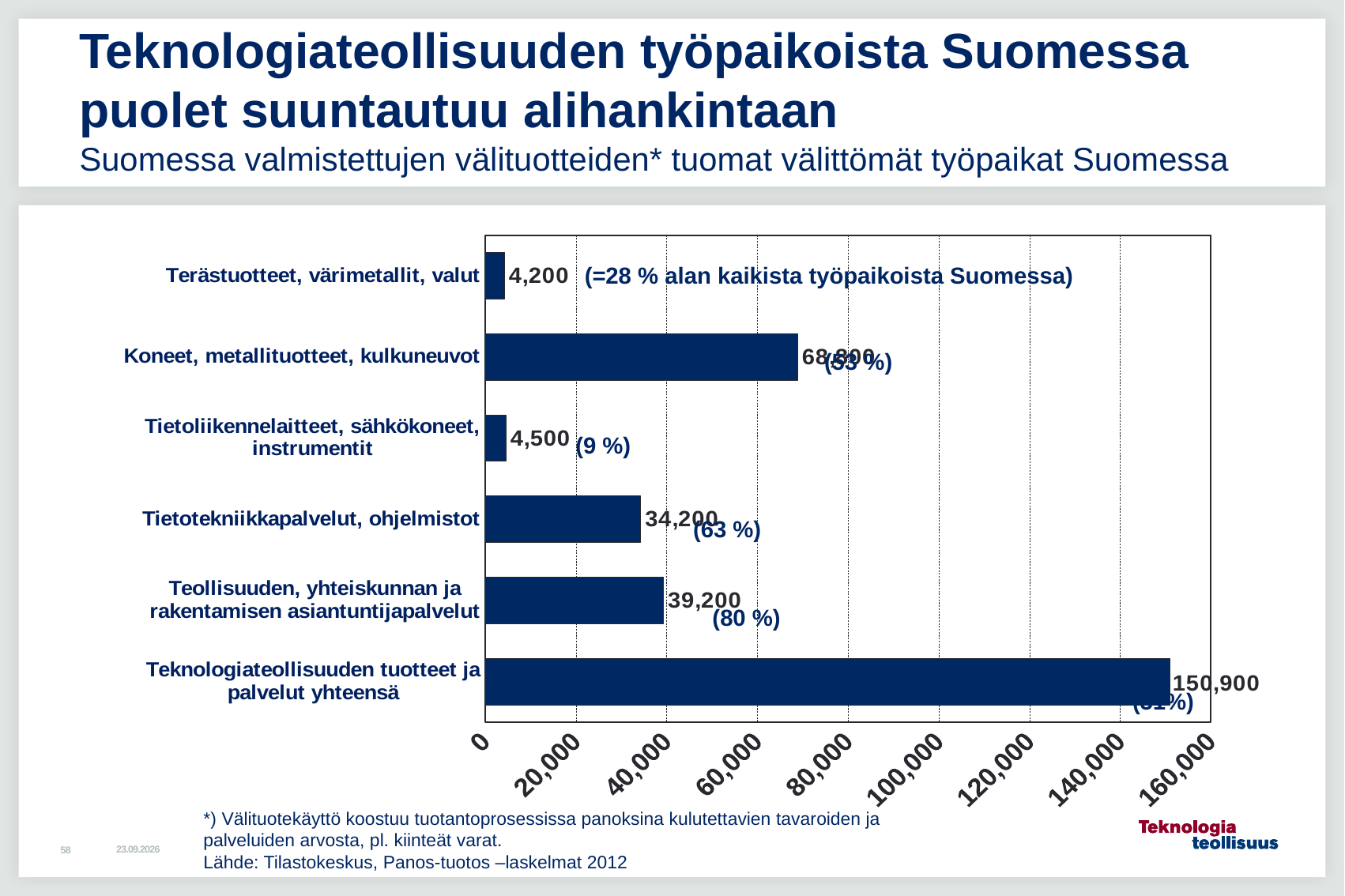
Which category has the lowest value? Terästuotteet, värimetallit, valut How many categories are shown in the chart? 6 What is the value for Teknologiateollisuuden tuotteet ja palvelut yhteensä? 150,900 What is the difference between the values for Teollisuuden, yhteiskunnan ja rakentamisen asiantuntijapalvelut and Tietotekniikkapalvelut, ohjelmistot? 5,000 What kind of chart is shown on the slide? bar chart What is the value for Teollisuuden, yhteiskunnan ja rakentamisen asiantuntijapalvelut? 39,200 Is the value for Koneet, metallituotteet, kulkuneuvot greater or less than 60,000? greater What is the value for Tietotekniikkapalvelut, ohjelmistot? 34,200 Which category has the highest value? Teknologiateollisuuden tuotteet ja palvelut yhteensä What is the value for Terästuotteet, värimetallit, valut? 4,200 What is the value for Tietoliikennelaitteet, sähkökoneet, instrumentit? 4,500 Which is larger: Tietotekniikkapalvelut, ohjelmistot or Teollisuuden, yhteiskunnan ja rakentamisen asiantuntijapalvelut? Teollisuuden, yhteiskunnan ja rakentamisen asiantuntijapalvelut